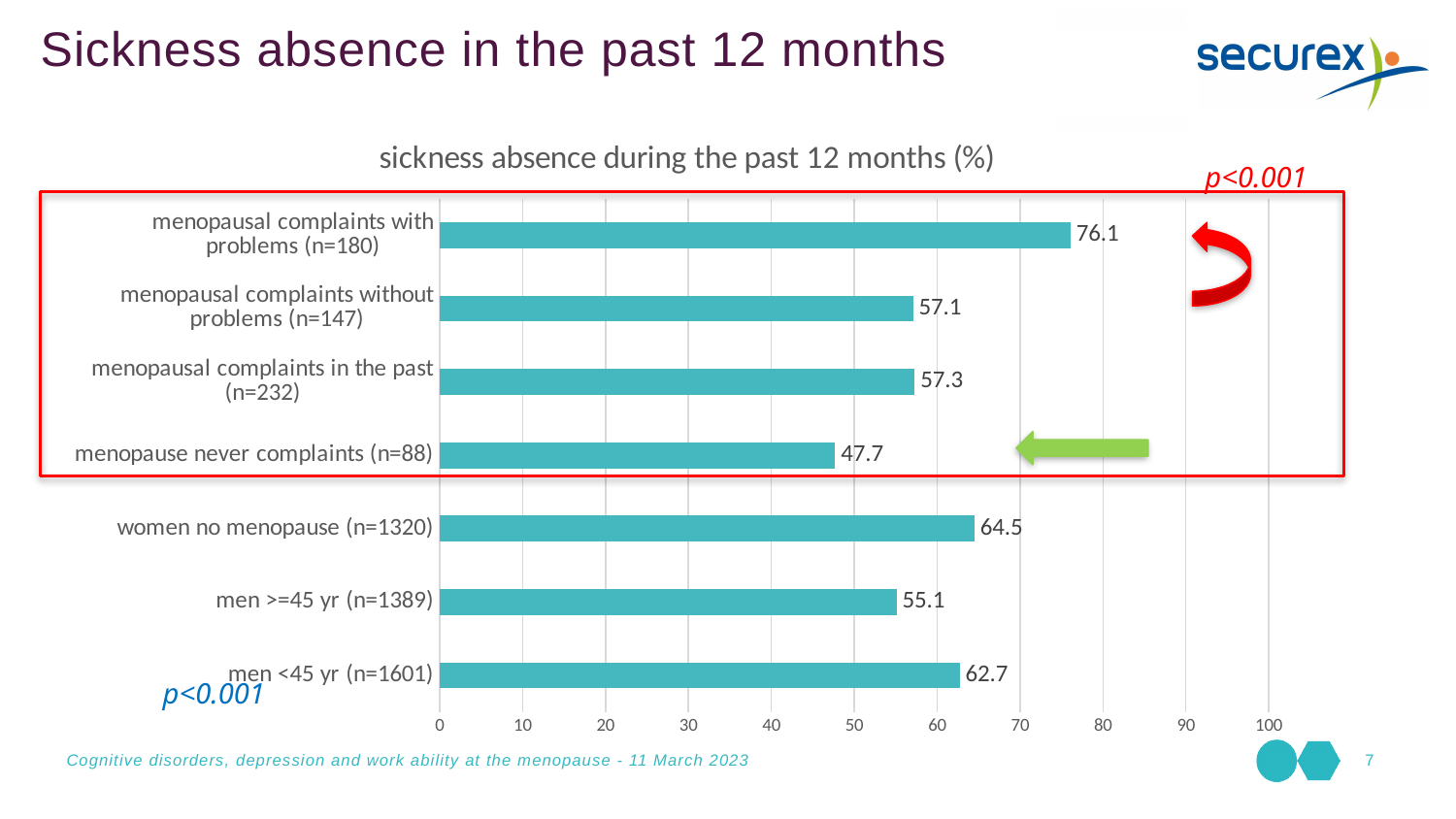
What is the sickness absence value for menopausal complaints with problems (n=180)? 76.1 What is the difference between the values for men <45 yr (n=1601) and men >=45 yr (n=1389)? 7.6 What is the title of the chart? sickness absence during the past 12 months (%) What kind of chart is shown on the slide? bar chart Which category has the highest sickness absence value? menopausal complaints with problems (n=180) What is the difference between the values for menopausal complaints with problems (n=180) and menopause never complaints (n=88)? 28.4 How many categories are shown in the chart? 7 Which is larger: the value for women no menopause (n=1320) or the value for men <45 yr (n=1601)? women no menopause (n=1320) What is the sickness absence value for women no menopause (n=1320)? 64.5 What is the sickness absence value for men >=45 yr (n=1389)? 55.1 Is the value for menopause never complaints (n=88) greater or less than 50? less Which category has the lowest sickness absence value? menopause never complaints (n=88)